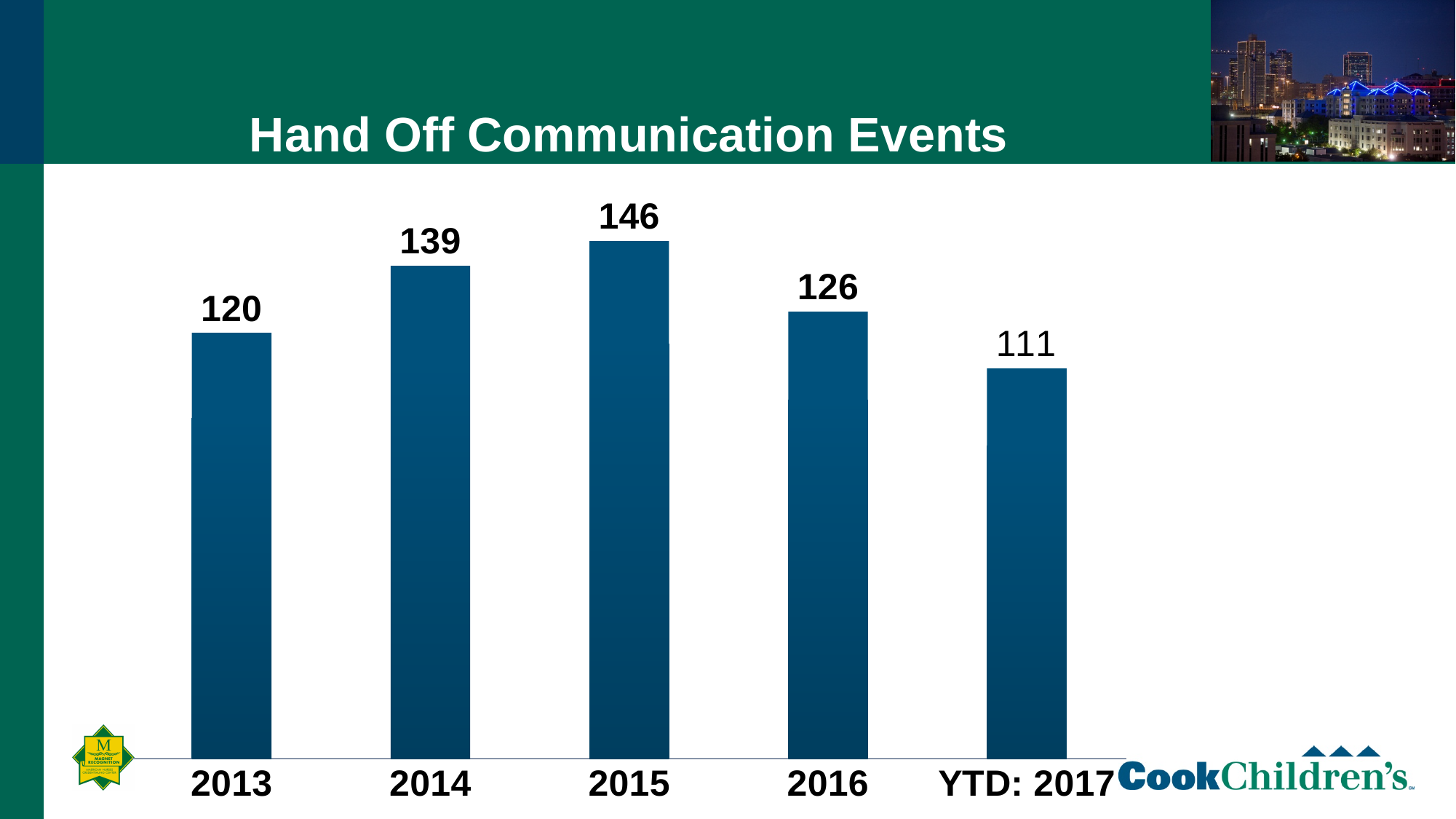
What is the difference between the values for 2014 and 2013? 19 What is the difference between the values for 2015 and 2016? 20 What is the value for 2013? 120 What is the title of the chart? Hand Off Communication Events Which year has the highest number of hand off communication events? 2015 What kind of chart is this? bar chart What is the value for 2015? 146 What is the value for YTD: 2017? 111 How many categories are shown on the x axis? 5 Which category has the lowest value? YTD: 2017 Do the values rise or fall from 2015 to YTD: 2017? fall Which is larger, the value for 2014 or the value for 2016? 2014